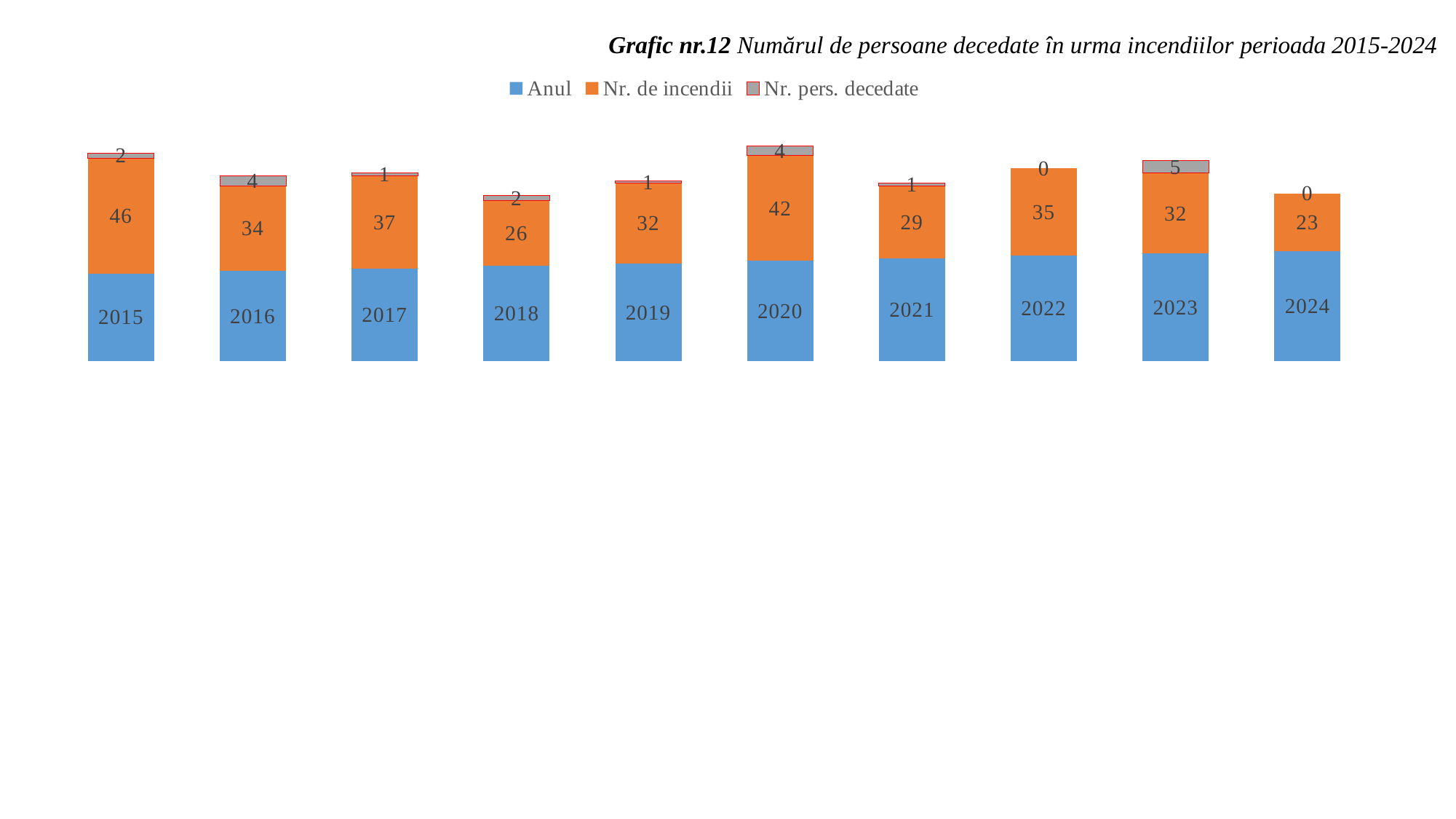
Which year has more fires (Nr. de incendii), 2017 or 2018? 2017 Which year has the lowest Nr. de incendii? 2024 What is the Nr. de incendii value for 2020? 42 Which year has the highest Nr. pers. decedate? 2023 What is the number of fires (Nr. de incendii) for 2015? 46 What type of chart is shown? Stacked bar chart How many years are shown on the chart? 10 Which year has the highest Nr. de incendii? 2015 What is the difference in Nr. de incendii between 2015 and 2024? 23 What is the title of the chart? Grafic nr.12 Numărul de persoane decedate în urma incendiilor perioada 2015-2024 How many persons deceased (Nr. pers. decedate) are shown for 2023? 5 How many series does the legend list? 3